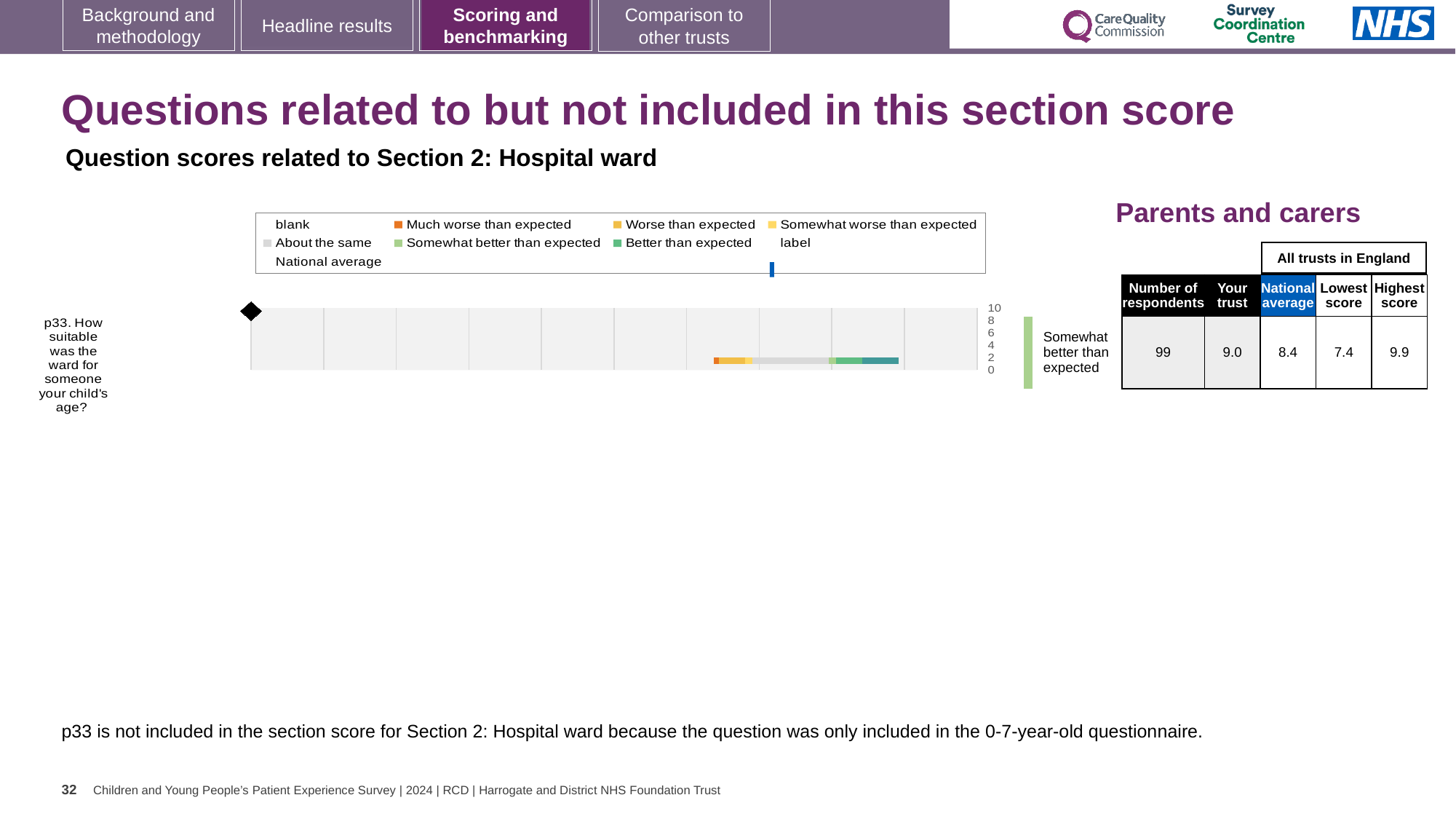
What is the highest score among all trusts in England for p33? 9.9 What is the difference between the highest and lowest scores for p33 across all trusts in England? 2.5 What is the national average score for p33? 8.4 Which colour in the legend represents 'Much worse than expected'? orange What is the 'Your trust' score for p33 in the table beside the chart? 9.0 What is the difference between the 'Your trust' score and the national average for p33? 0.6 What is the lowest score among all trusts in England for p33? 7.4 How many respondents answered p33? 99 Which is higher for p33, the 'Your trust' score or the national average? Your trust What kind of chart is used to show the p33 question score? bar chart How many questions are plotted in the chart? 1 What benchmark category is shown next to the chart for p33? Somewhat better than expected